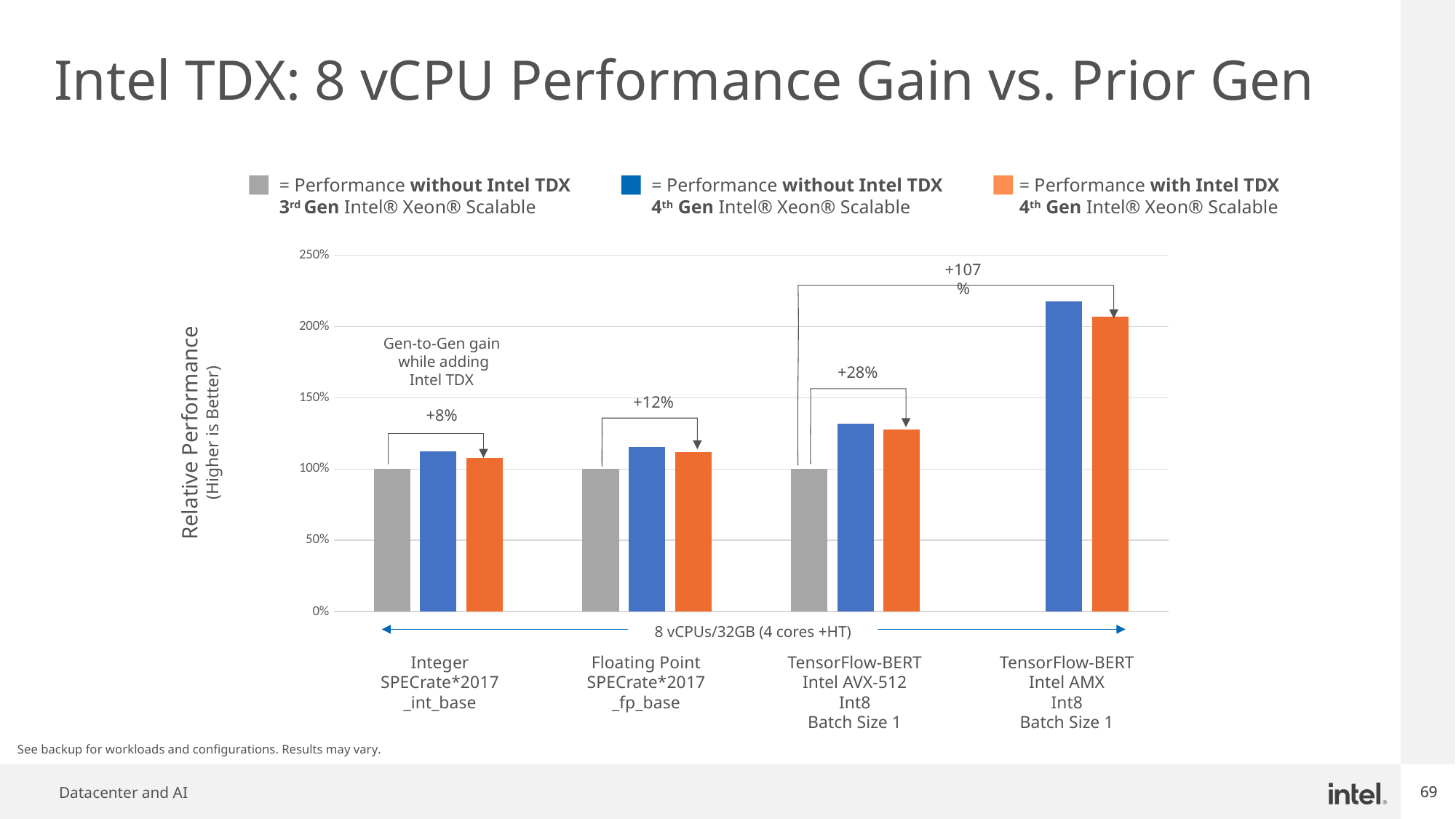
Which workload has the largest annotated gen-to-gen gain? TensorFlow-BERT Intel AMX Int8 Batch Size 1 What is the relative performance of the 3rd Gen Intel Xeon Scalable (without Intel TDX) bar for the Integer SPECrate*2017_int_base workload? 100% What gen-to-gen gain is annotated for the Floating Point SPECrate*2017_fp_base workload? +12% Do the 'with Intel TDX 4th Gen' bars rise or fall from left to right across the workloads? rise How many series does the legend list? 3 For TensorFlow-BERT Intel AMX, which bar is taller: 'without Intel TDX 4th Gen' or 'with Intel TDX 4th Gen'? without Intel TDX 4th Gen How many workload categories are shown along the x axis? 4 Is the value of the 'with Intel TDX 4th Gen' bar for TensorFlow-BERT Intel AMX greater or less than 200%? greater What gen-to-gen gain is annotated for TensorFlow-BERT Intel AVX-512 Int8 Batch Size 1? +28% What gen-to-gen gain is annotated for the Integer SPECrate*2017_int_base workload? +8% What kind of chart is shown on the slide? bar chart What gen-to-gen gain is annotated for TensorFlow-BERT Intel AMX Int8 Batch Size 1? +107%